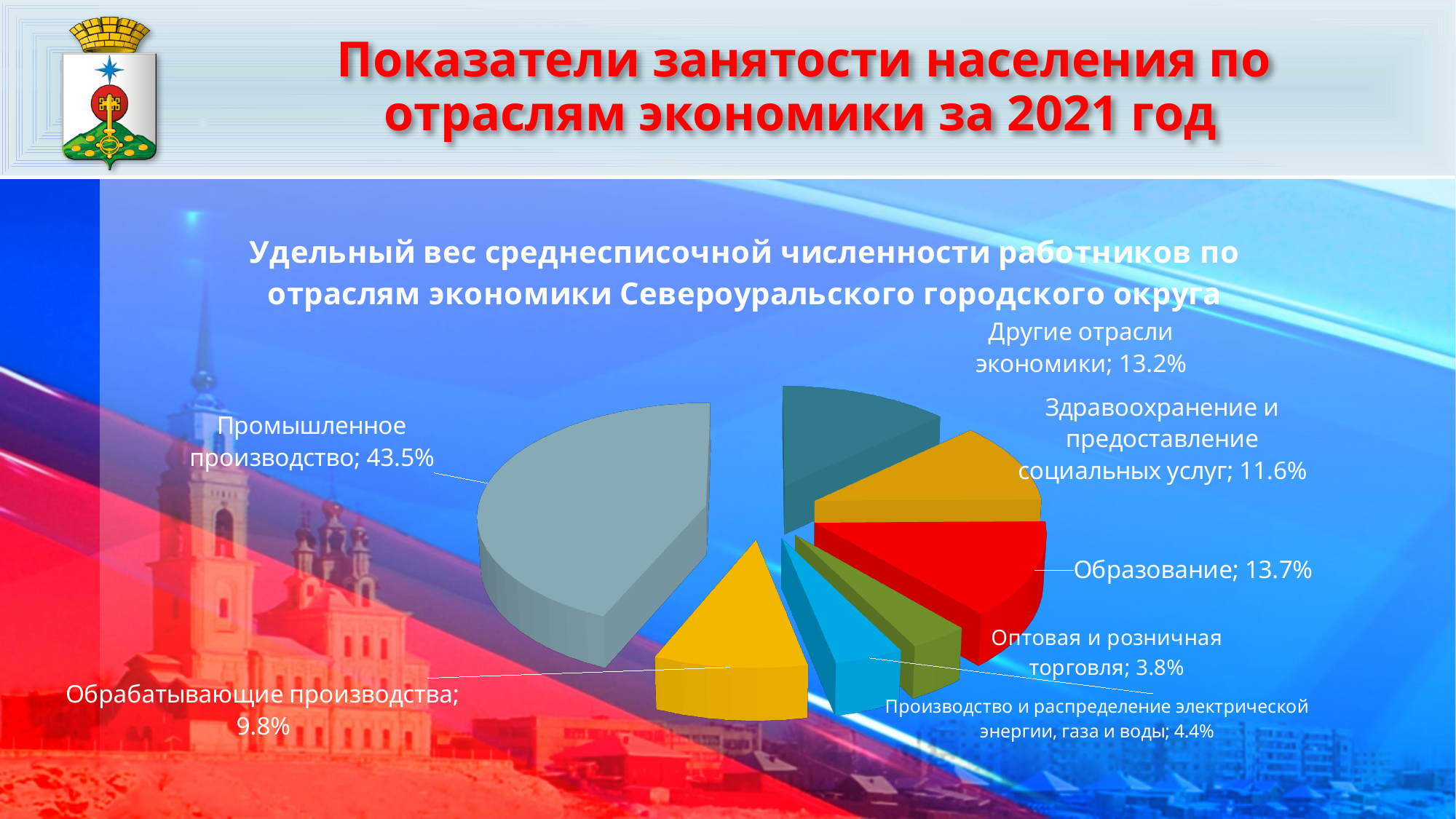
Какова доля отрасли «Промышленное производство» на диаграмме? 43.5% Какая отрасль имеет наибольшую долю на диаграмме? Промышленное производство Какова доля отрасли «Оптовая и розничная торговля»? 3.8% Что больше: доля отрасли «Другие отрасли экономики» или доля отрасли «Здравоохранение и предоставление социальных услуг»? Другие отрасли экономики Какова доля отрасли «Здравоохранение и предоставление социальных услуг»? 11.6% На сколько процентных пунктов доля отрасли «Образование» больше доли отрасли «Обрабатывающие производства»? 3.9 Какая отрасль имеет наименьшую долю на диаграмме? Оптовая и розничная торговля Какой тип диаграммы показан на слайде? Круговая диаграмма Какова доля отрасли «Производство и распределение электрической энергии, газа и воды»? 4.4% Каким цветом на диаграмме показан сектор «Образование»? Красным Какова доля отрасли «Образование» на диаграмме? 13.7% Сколько секторов (отраслей) показано на круговой диаграмме? 7